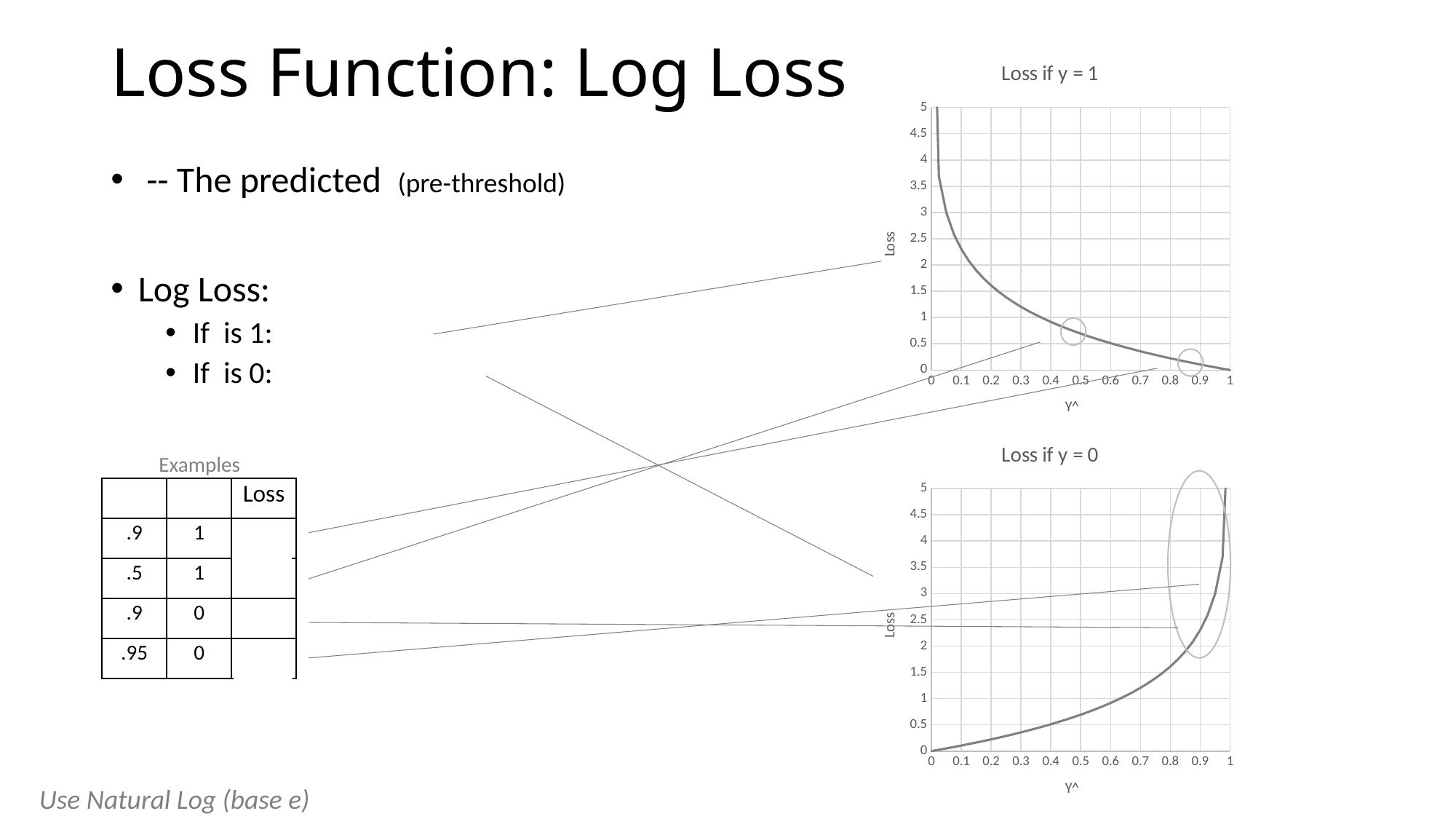
In the "Loss if y = 1" chart, does the loss rise or fall as Y^ increases from 0 to 1? fall What kind of chart is the "Loss if y = 0" chart? line chart In the "Loss if y = 0" chart, does the loss rise or fall as Y^ increases from 0 to 1? rise What is the title of the upper chart on the slide? Loss if y = 1 In the "Loss if y = 0" chart, is the loss at Y^ = 0.2 greater or less than 0.5? less In the "Loss if y = 1" chart, is the loss at Y^ = 0.5 greater or less than 1? less In the "Loss if y = 1" chart, is the loss at Y^ = 0.9 greater or less than 0.5? less What is the label on the x axis of the "Loss if y = 0" chart? Y^ What kind of chart is the "Loss if y = 1" chart? line chart